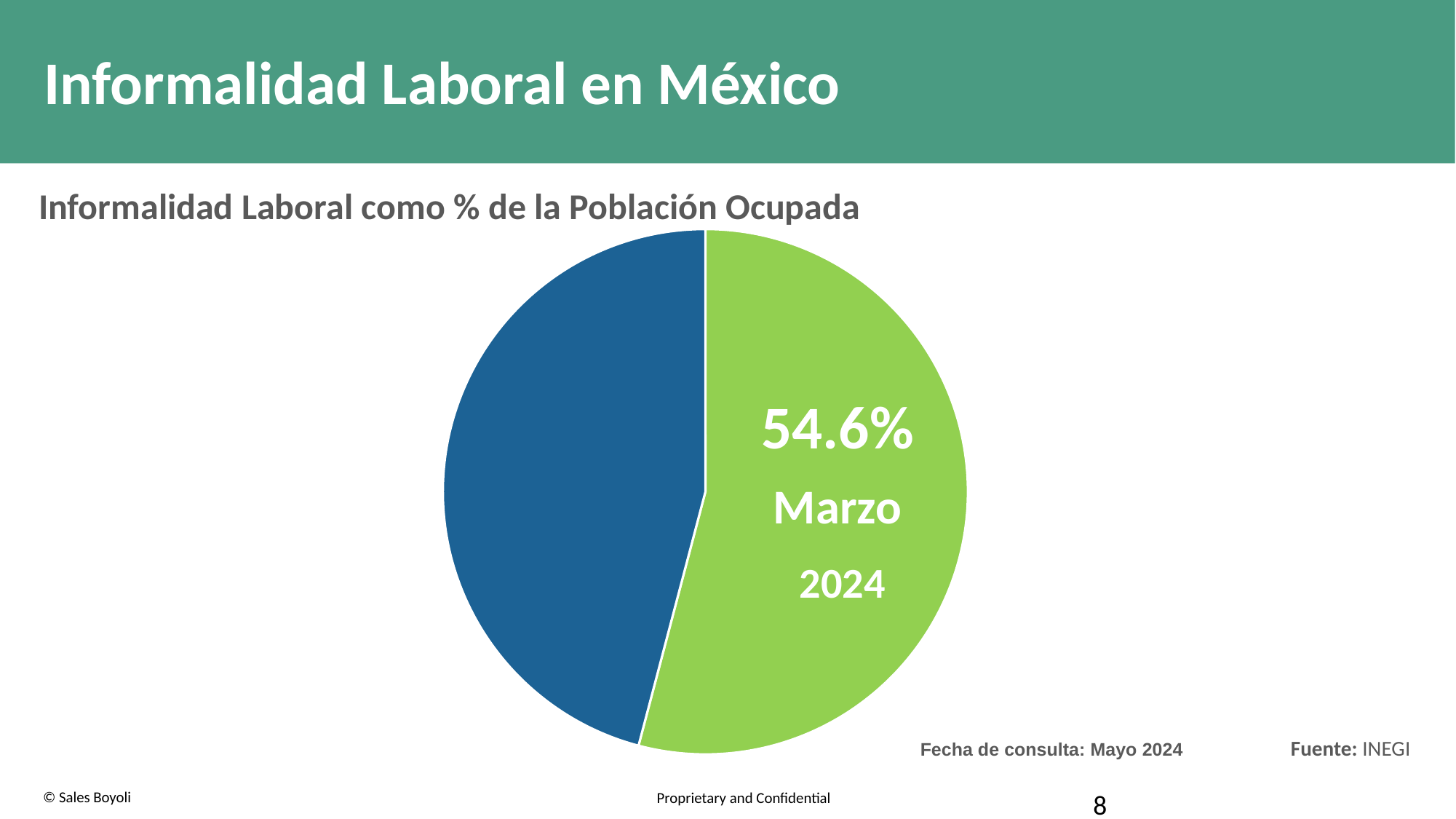
What is the title of the chart on the slide? Informalidad Laboral como % de la Población Ocupada What colour is the slice of the pie chart that carries the 54.6% label? Green What share of the pie does the green slice labelled Marzo 2024 represent? 54.6% Which slice of the pie chart is the largest? The green slice (54.6%) What kind of chart is shown on the slide? Pie chart How many slices does the pie chart have? 2 What month and year are printed on the labelled slice of the pie chart? Marzo 2024 What value is printed on the green slice of the pie chart? 54.6% Which slice of the pie chart is larger, the green one or the blue one? The green one Which slice of the pie chart is the smallest? The blue slice